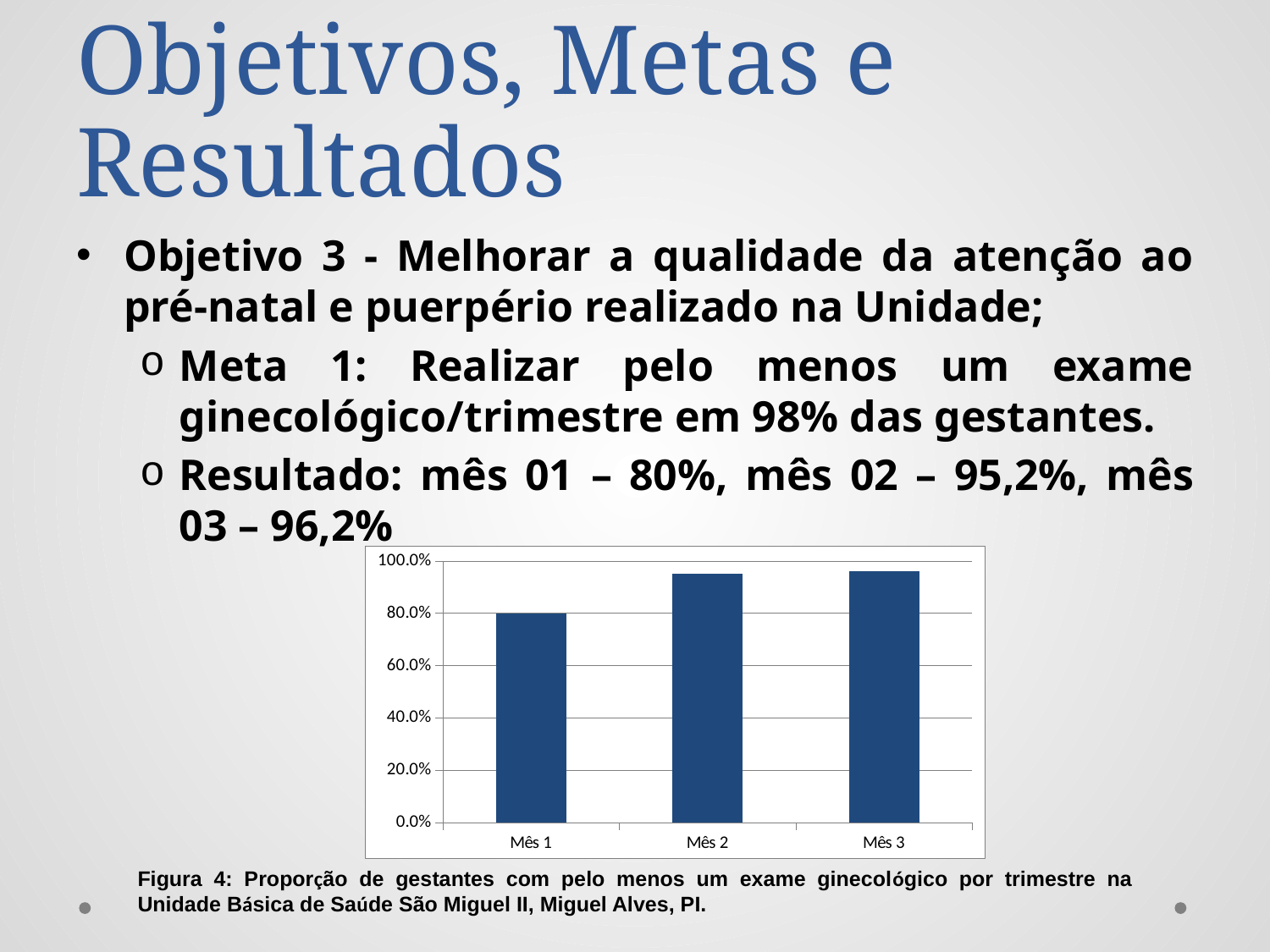
Do the values rise or fall from Mês 1 to Mês 3? rise Which is larger, the value for Mês 1 or the value for Mês 3? Mês 3 How many categories (months) are plotted on the chart? 3 What is the figure number given in the caption below the chart? Figura 4 Is the value for Mês 1 greater or less than 100.0%? less What is the value for Mês 1 on the chart? 80.0% Is the value for Mês 2 greater or less than 80.0%? greater What kind of chart is shown on the slide? bar chart Which month has the lowest value on the chart? Mês 1 What colour are the bars in the chart? blue Is the value for Mês 3 greater or less than 100.0%? less Which is larger, the value for Mês 1 or the value for Mês 2? Mês 2